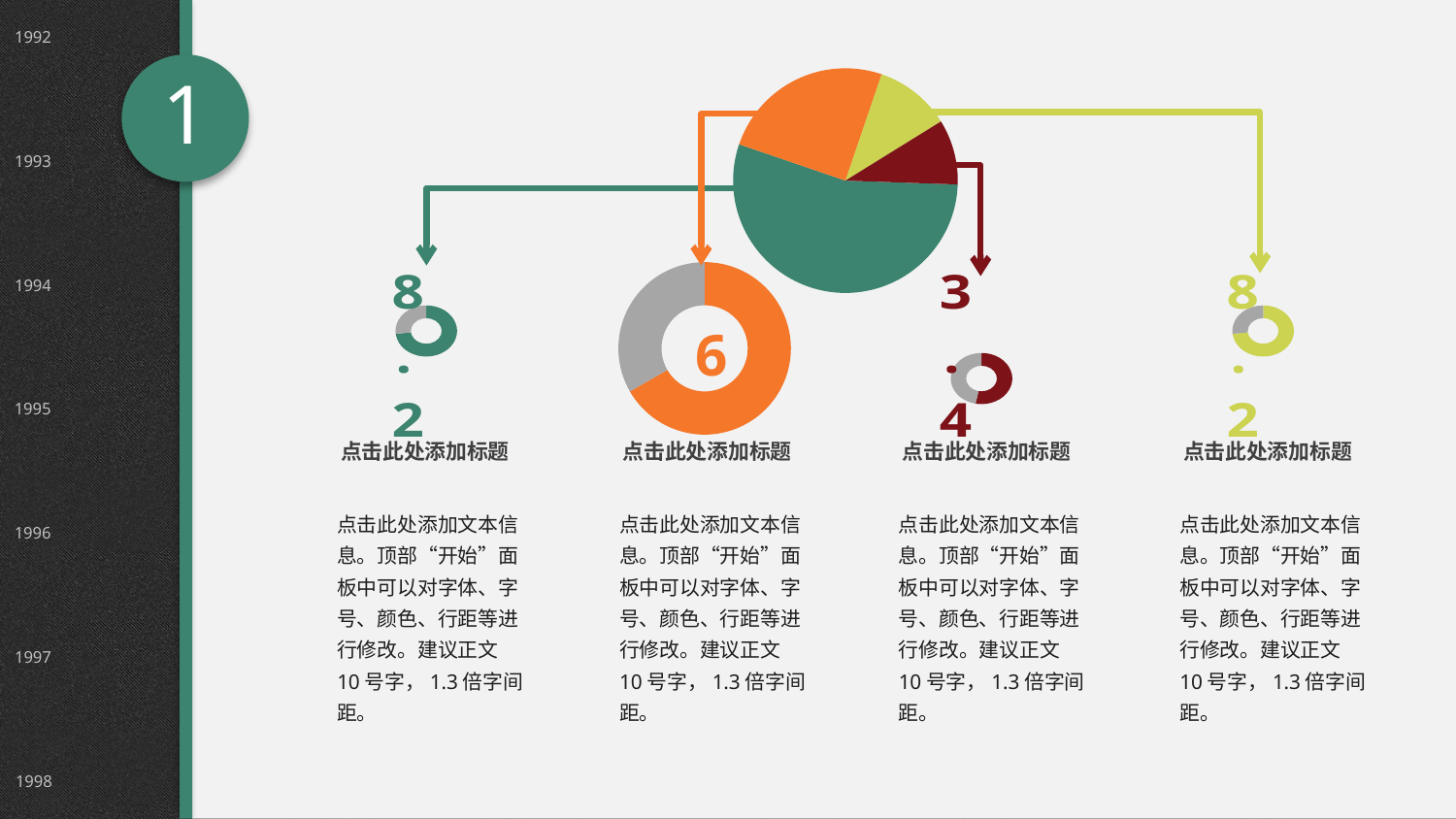
What number is printed beside the dark red donut chart (third from the left)? 3.4 How many small donut charts are shown below the pie chart? 4 What number is printed on the orange donut chart (second from the left)? 6 In the large pie chart at the top of the slide, is the green slice or the orange slice larger? green What kind of chart is the large chart at the top of the slide? pie chart In the large pie chart at the top of the slide, which colour slice is the largest? green How many slices does the large pie chart at the top of the slide have? 4 What kind of chart are the four small charts below the pie chart? donut chart What number is printed beside the yellow-green donut chart (rightmost)? 8.2 In the large pie chart at the top of the slide, is the orange slice or the yellow-green slice larger? orange What number is printed beside the green donut chart (leftmost)? 8.2 In the large pie chart at the top of the slide, is the green slice greater or less than half of the pie? greater